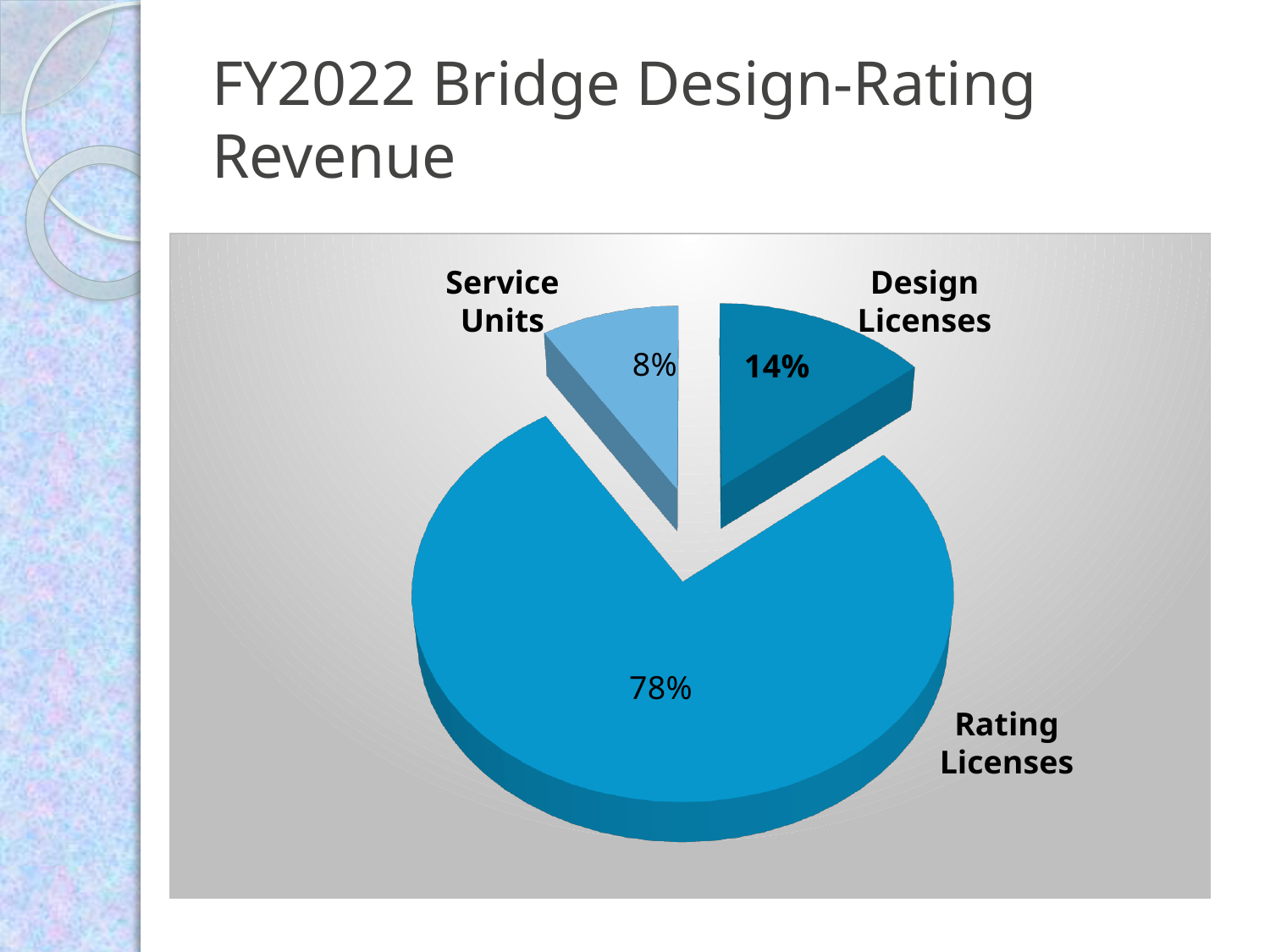
What is the title of the slide containing the chart? FY2022 Bridge Design-Rating Revenue Which category has the smallest slice of the pie? Service Units How many categories are shown in the pie chart? 3 What is the combined share of Design Licenses and Service Units? 22% What share of the pie is Service Units? 8% What kind of chart is shown on the slide? Pie chart Which category has the largest slice of the pie? Rating Licenses What share of the pie is Design Licenses? 14% What is the difference in percentage points between Rating Licenses and Design Licenses? 64 Which is larger, the Design Licenses slice or the Service Units slice? Design Licenses What is the difference in percentage points between Design Licenses and Service Units? 6 What share of FY2022 Bridge Design-Rating Revenue comes from Rating Licenses? 78%